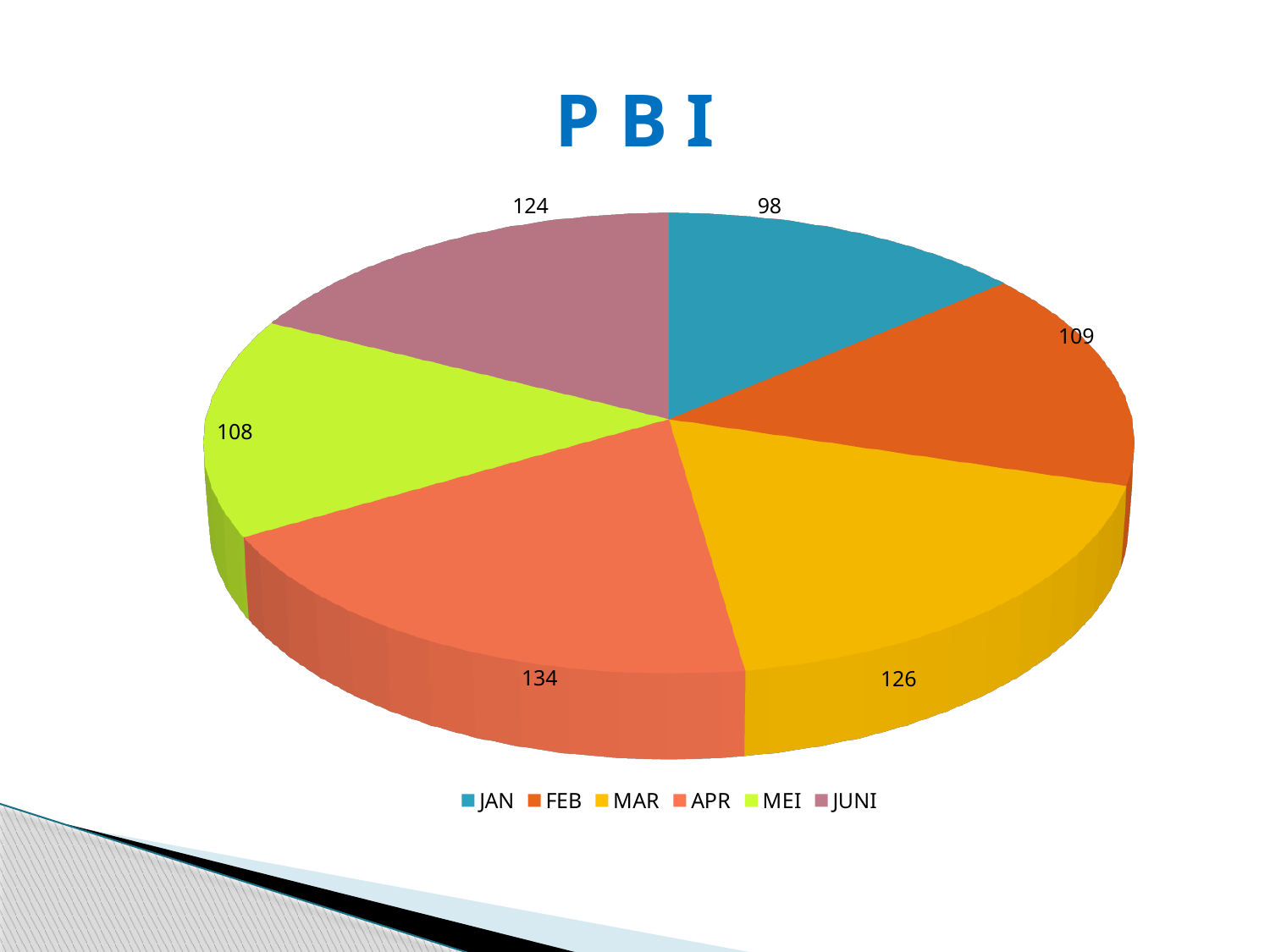
What is the difference between the values for APR and JAN? 36 How many categories does the pie chart show? 6 Which is larger, the value for FEB or the value for MEI? FEB What is the total of all the values in the pie chart? 699 What is the difference between the values for MAR and JUNI? 2 What is the value for APR in the pie chart? 134 What kind of chart is shown on the slide? Pie chart Which month has the largest slice in the pie chart? APR Which month has the smallest slice in the pie chart? JAN What is the value for MEI in the pie chart? 108 What is the value for JUNI in the pie chart? 124 What is the title of the chart? P B I